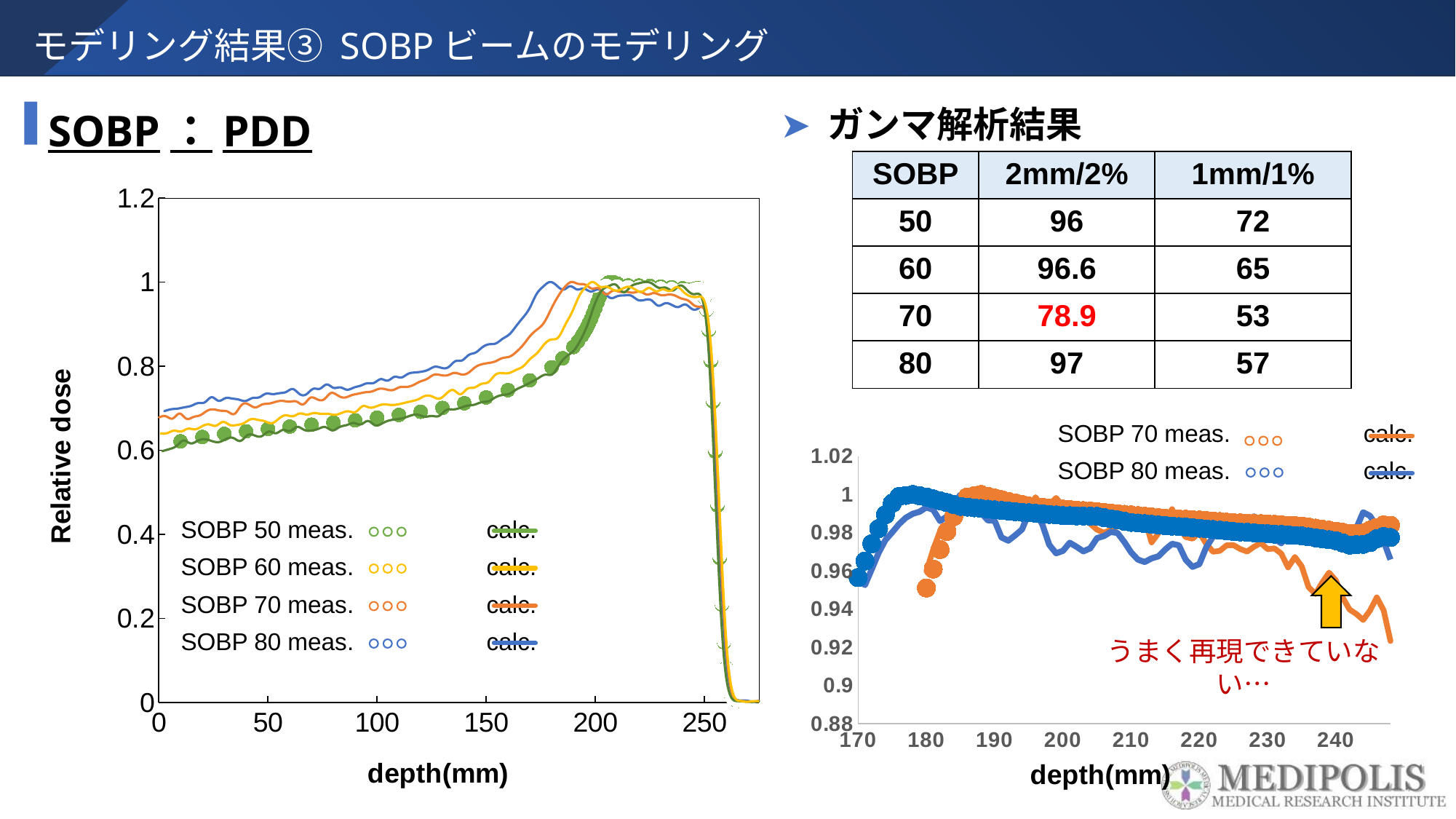
On the left chart "SOBP : PDD", does the SOBP 80 calc. curve rise or fall between depth 0 mm and 150 mm? rise On the left chart "SOBP : PDD", is the SOBP 50 meas. value at depth 100 mm greater or less than 0.8? less On the left chart "SOBP : PDD", how many SOBP widths are listed in the legend? 4 What kind of chart is the left chart titled "SOBP : PDD"? line chart On the right (zoomed) chart, does the SOBP 70 meas. series rise or fall between depth 190 mm and 240 mm? fall On the right (zoomed) chart, is the SOBP 70 calc. value at depth 240 mm greater or less than 0.96? less On the left chart "SOBP : PDD", what is the label of the y axis? Relative dose On the left chart "SOBP : PDD", is the SOBP 80 calc. value at depth 0 mm greater or less than 0.6? greater On the right (zoomed) chart, what is the lowest depth value shown on the x axis? 170 On the right (zoomed) chart, which SOBP widths are listed in the legend? SOBP 70 and SOBP 80 On the left chart "SOBP : PDD", at depth 50 mm, which is higher: the SOBP 80 calc. curve or the SOBP 50 calc. curve? SOBP 80 calc. On the left chart "SOBP : PDD", what is the label of the x axis? depth(mm)